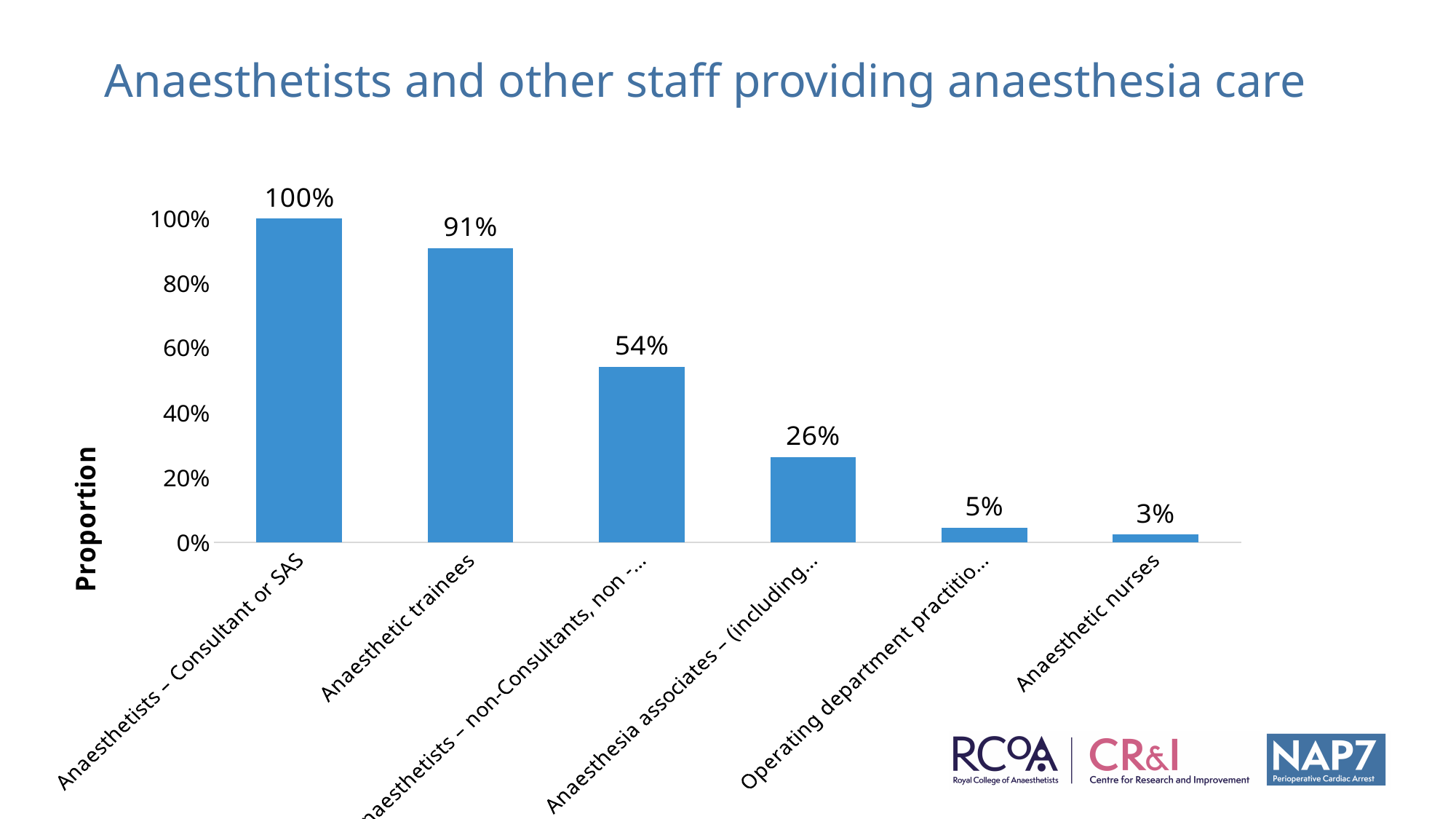
Which category has the highest value? Anaesthetists – Consultant or SAS What is the label of the vertical axis? Proportion Do the values rise or fall from left to right along the x axis? fall How many categories are shown in the chart? 6 Which category has the lowest value? Anaesthetic nurses What is the difference between the values for Anaesthetic trainees and Anaesthetic nurses? 88% What kind of chart is shown on the slide? bar chart What is the value for Anaesthetic nurses? 3% What is the value for Anaesthetic trainees? 91% What is the value for Anaesthetists – Consultant or SAS? 100% Is the value for Anaesthetic trainees greater or less than 80%? greater Which is larger, the value for Anaesthetic trainees or the value for Anaesthetic nurses? Anaesthetic trainees